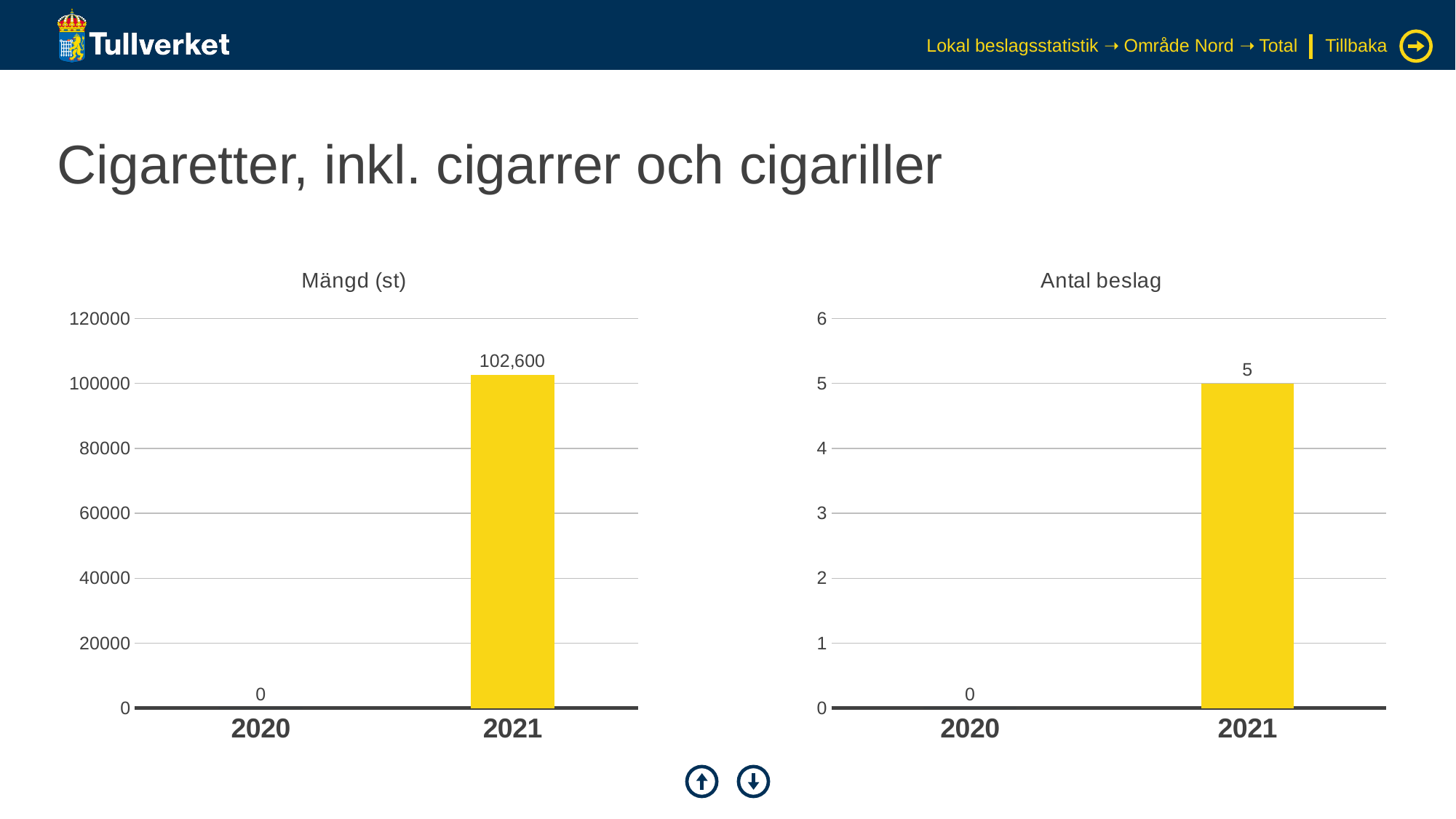
In the 'Mängd (st)' chart, is the value for 2021 greater or less than 100000? greater In the 'Mängd (st)' chart, what is the value for 2020? 0 In the 'Mängd (st)' chart, what is the difference between the 2021 and 2020 values? 102,600 In the 'Mängd (st)' chart, what is the value for 2021? 102,600 In the 'Antal beslag' chart, do the values rise or fall from 2020 to 2021? rise In the 'Antal beslag' chart, what is the value for 2020? 0 What kind of chart is the 'Mängd (st)' chart? bar chart In the 'Antal beslag' chart, which year has the lowest value? 2020 How many categories are shown on the x axis of the 'Antal beslag' chart? 2 In the 'Mängd (st)' chart, which year has the highest value? 2021 In the 'Antal beslag' chart, what is the value for 2021? 5 In the 'Antal beslag' chart, what is the difference between the 2021 and 2020 values? 5